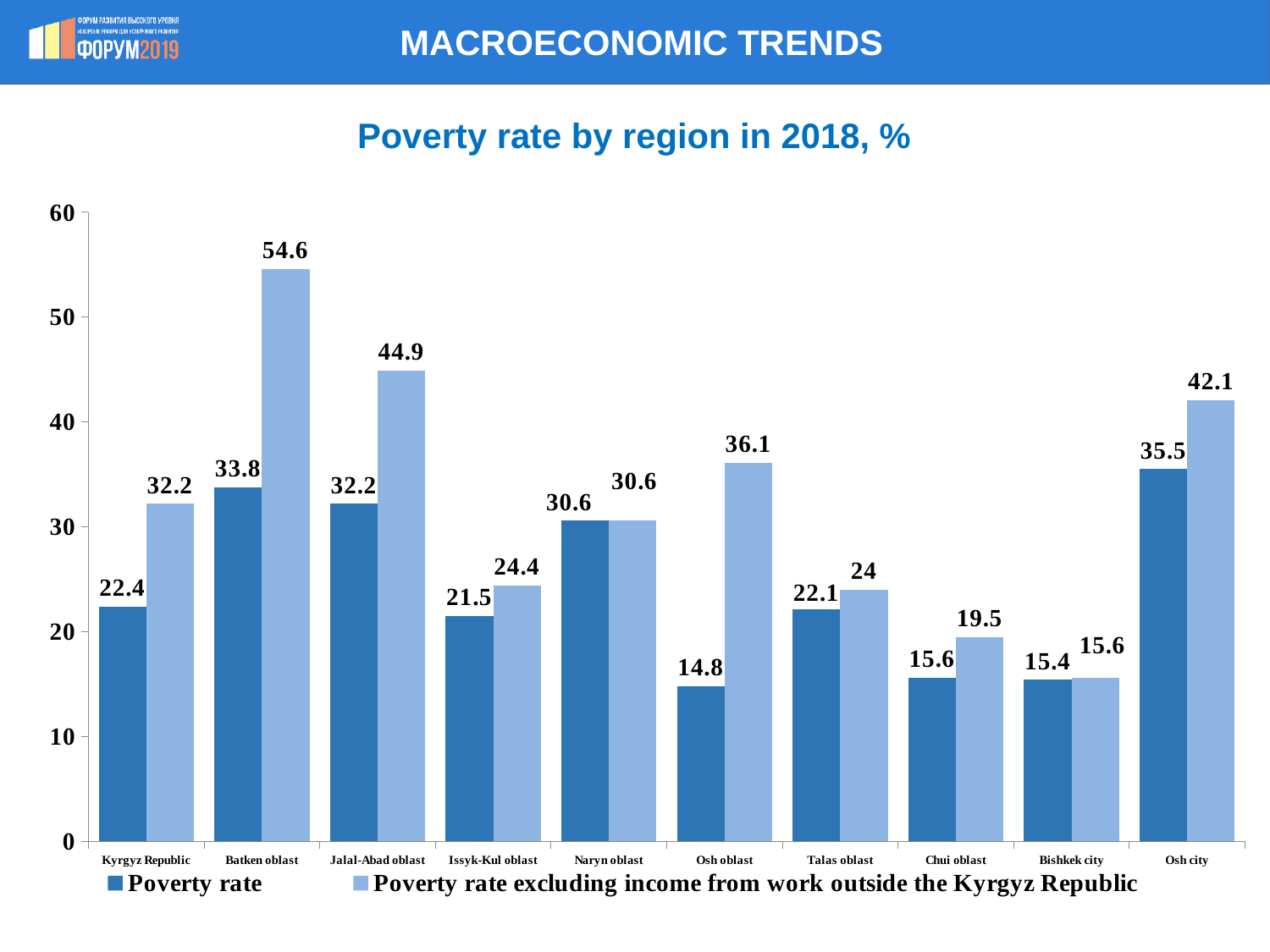
What is the poverty rate excluding income from work outside the Kyrgyz Republic for Osh oblast? 36.1 Which is larger: the poverty rate for Osh city or for Batken oblast? Osh city How many regions (categories) are shown on the x axis? 10 How many series does the legend list? 2 Which region has the highest poverty rate excluding income from work outside the Kyrgyz Republic? Batken oblast What is the difference between the two series for Osh oblast? 21.3 What kind of chart is shown on the slide? bar chart What is the title of the chart? Poverty rate by region in 2018, % Which region has the lowest poverty rate? Osh oblast Is the poverty rate excluding income from work outside the Kyrgyz Republic for Jalal-Abad oblast greater or less than 40? greater What is the poverty rate for the Kyrgyz Republic as a whole? 22.4 What is the poverty rate for Batken oblast? 33.8